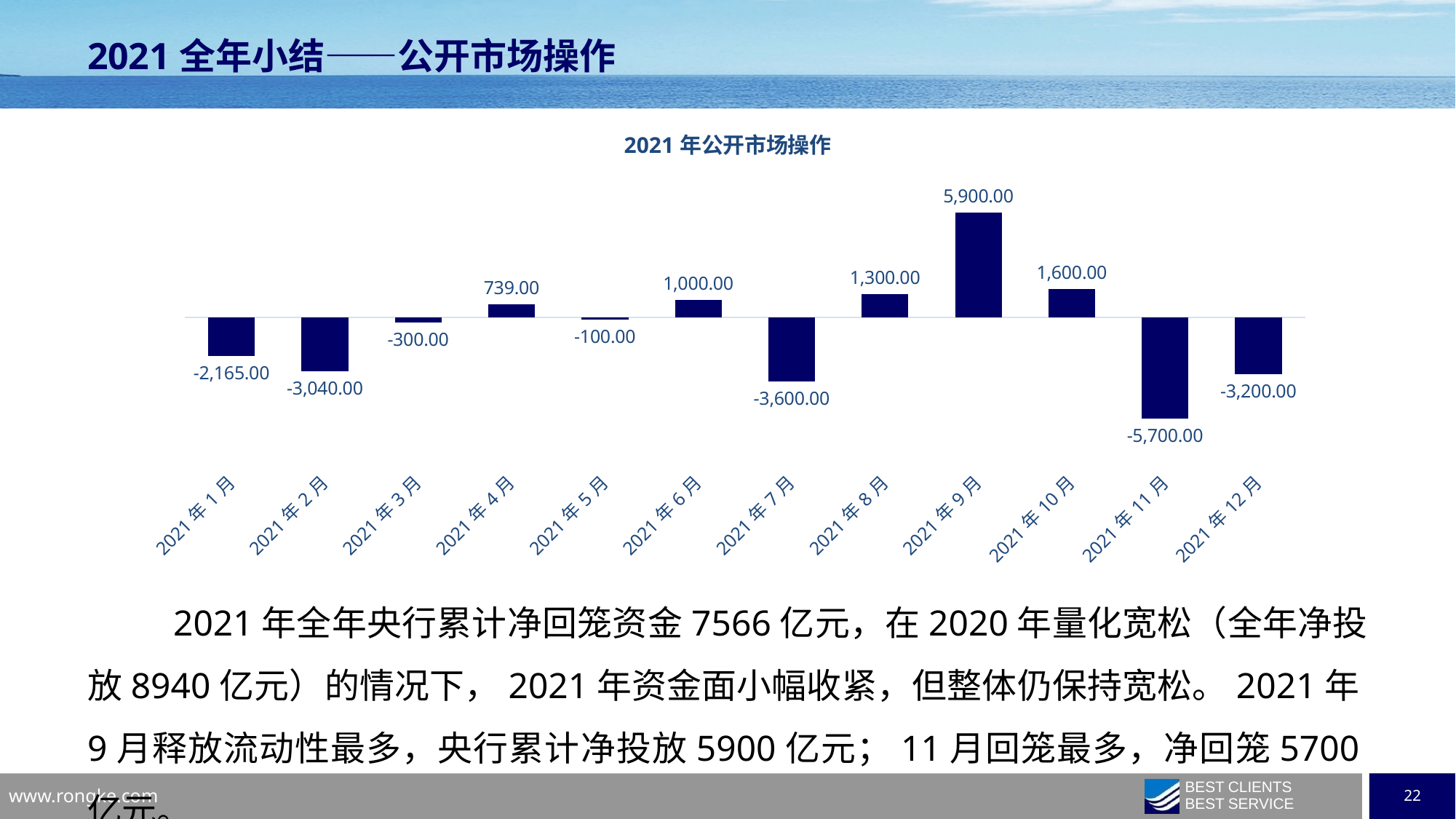
What kind of chart is shown on the slide? Bar chart What is the difference between the values for 2021 年 10 月 and 2021 年 8 月? 300.00 What is the value for 2021 年 11 月 in the chart? -5,700.00 Which is larger, the value for 2021 年 2 月 or the value for 2021 年 12 月? 2021 年 2 月 What is the value for 2021 年 1 月 in the chart? -2,165.00 What is the value for 2021 年 9 月 in the chart? 5,900.00 What is the value for 2021 年 4 月 in the chart? 739.00 What is the title of the chart? 2021 年公开市场操作 Which month has the highest value in the chart? 2021 年 9 月 How many months are plotted in the chart? 12 What is the difference between the values for 2021 年 9 月 and 2021 年 11 月? 11,600.00 Which month has the lowest value in the chart? 2021 年 11 月